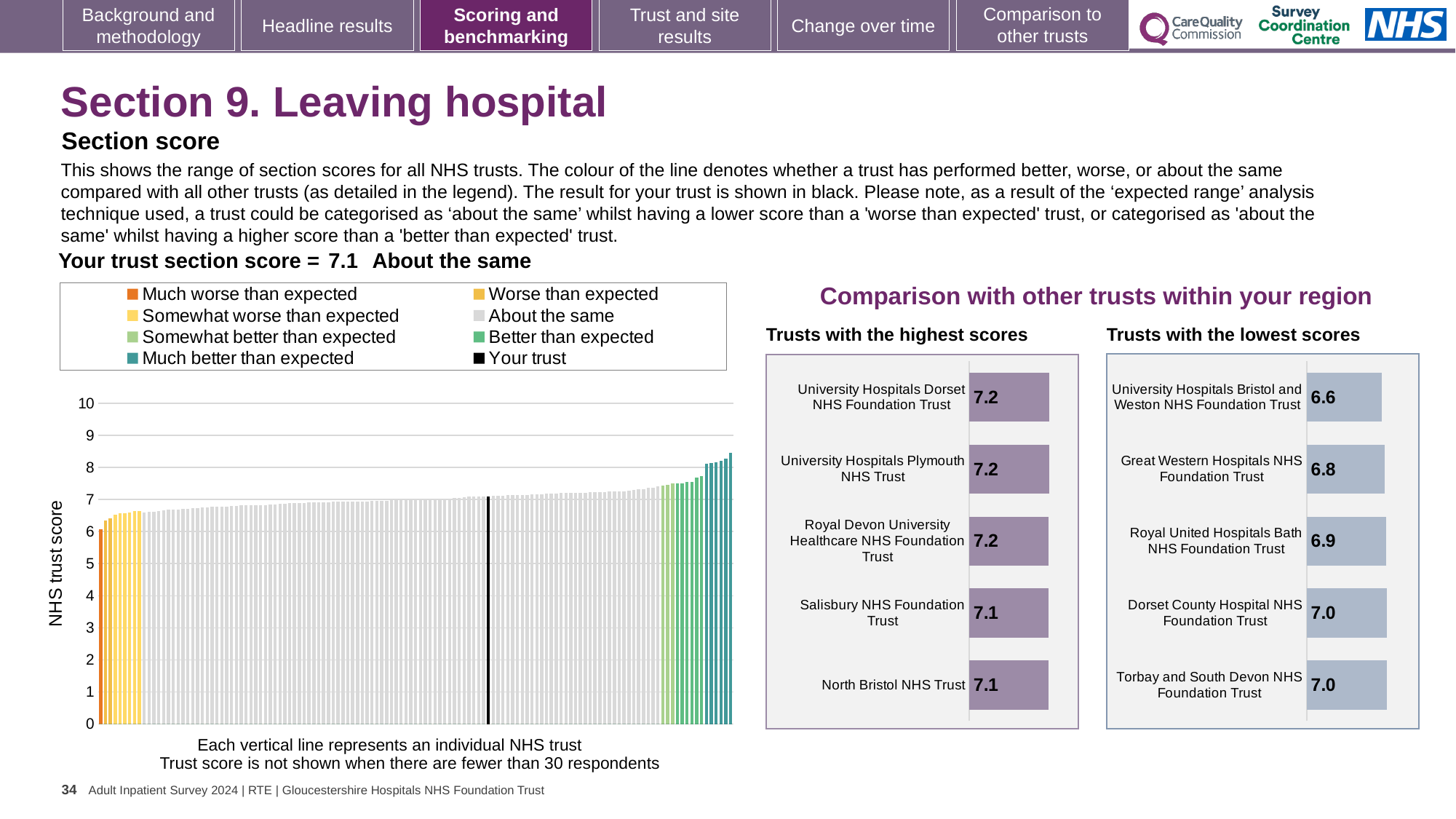
How many trusts are shown in the 'Trusts with the highest scores' chart? 5 In the 'Trusts with the lowest scores' chart, what is the score for Great Western Hospitals NHS Foundation Trust? 6.8 In the 'Trusts with the lowest scores' chart, which has the higher score: Great Western Hospitals NHS Foundation Trust or Royal United Hospitals Bath NHS Foundation Trust? Royal United Hospitals Bath NHS Foundation Trust In the 'Trusts with the lowest scores' chart, what is the difference between the scores of Royal United Hospitals Bath NHS Foundation Trust and University Hospitals Bristol and Weston NHS Foundation Trust? 0.3 In the main chart of NHS trust scores on the left, do the values rise or fall from left to right? rise In the 'Trusts with the highest scores' chart, what is the score for Salisbury NHS Foundation Trust? 7.1 In the main chart of NHS trust scores on the left, what is the section score for your trust? 7.1 In the 'Trusts with the lowest scores' chart, what is the difference between the scores of Torbay and South Devon NHS Foundation Trust and Great Western Hospitals NHS Foundation Trust? 0.2 In the main chart of NHS trust scores on the left, is the value for the rightmost trust greater or less than 8? greater In the 'Trusts with the lowest scores' chart, which trust has the lowest score? University Hospitals Bristol and Weston NHS Foundation Trust What kind of chart is the 'Trusts with the highest scores' chart? bar chart In the 'Trusts with the highest scores' chart, what is the score for North Bristol NHS Trust? 7.1